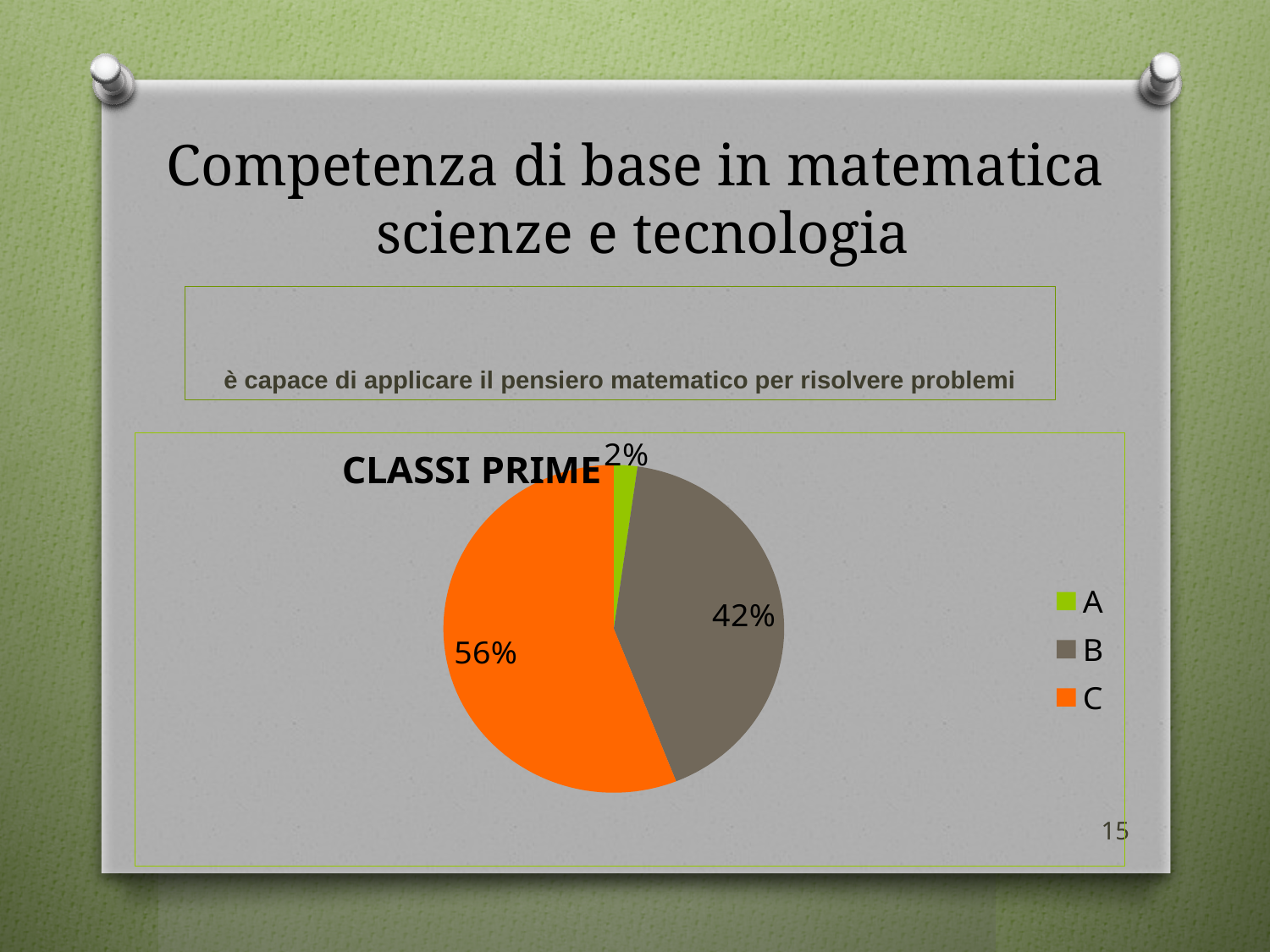
How many categories does the legend list? 3 What is the title of the chart? CLASSI PRIME How many slices does the pie chart have? 3 What kind of chart is shown on the slide? pie chart Which is larger, the share for B or the share for C? C Which category has the largest share of the pie? C What percentage does slice B represent? 42% What is the difference in percentage points between slice C and slice B? 14 Which category has the smallest share of the pie? A What colour is the slice for category C? orange What percentage does slice A represent? 2% What percentage does slice C represent? 56%